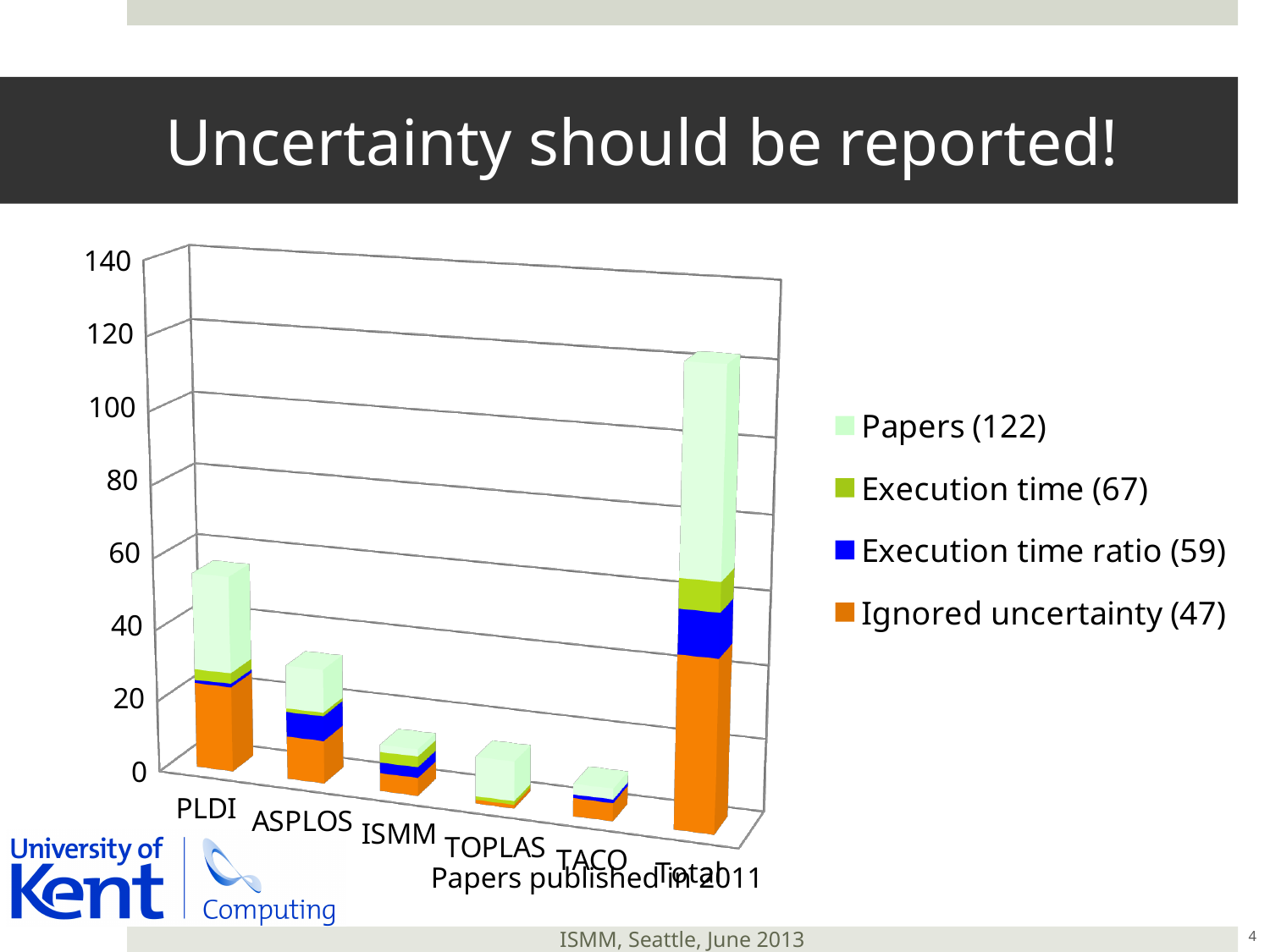
Is the total height of the Total bar greater or less than 100? greater Which category has the shortest stacked bar? TACO Is the total height of the ASPLOS bar greater or less than 40? less Is the total height of the TACO bar greater or less than 20? less Which category has the tallest stacked bar? Total What number appears in the legend entry for Ignored uncertainty? 47 What is the first entry listed in the chart's legend? Papers (122) How many series does the chart's legend list? 4 What kind of chart is shown on the slide? Stacked bar chart How many categories are shown along the x axis of the chart? 6 Which stacked bar is taller, PLDI or ASPLOS? PLDI